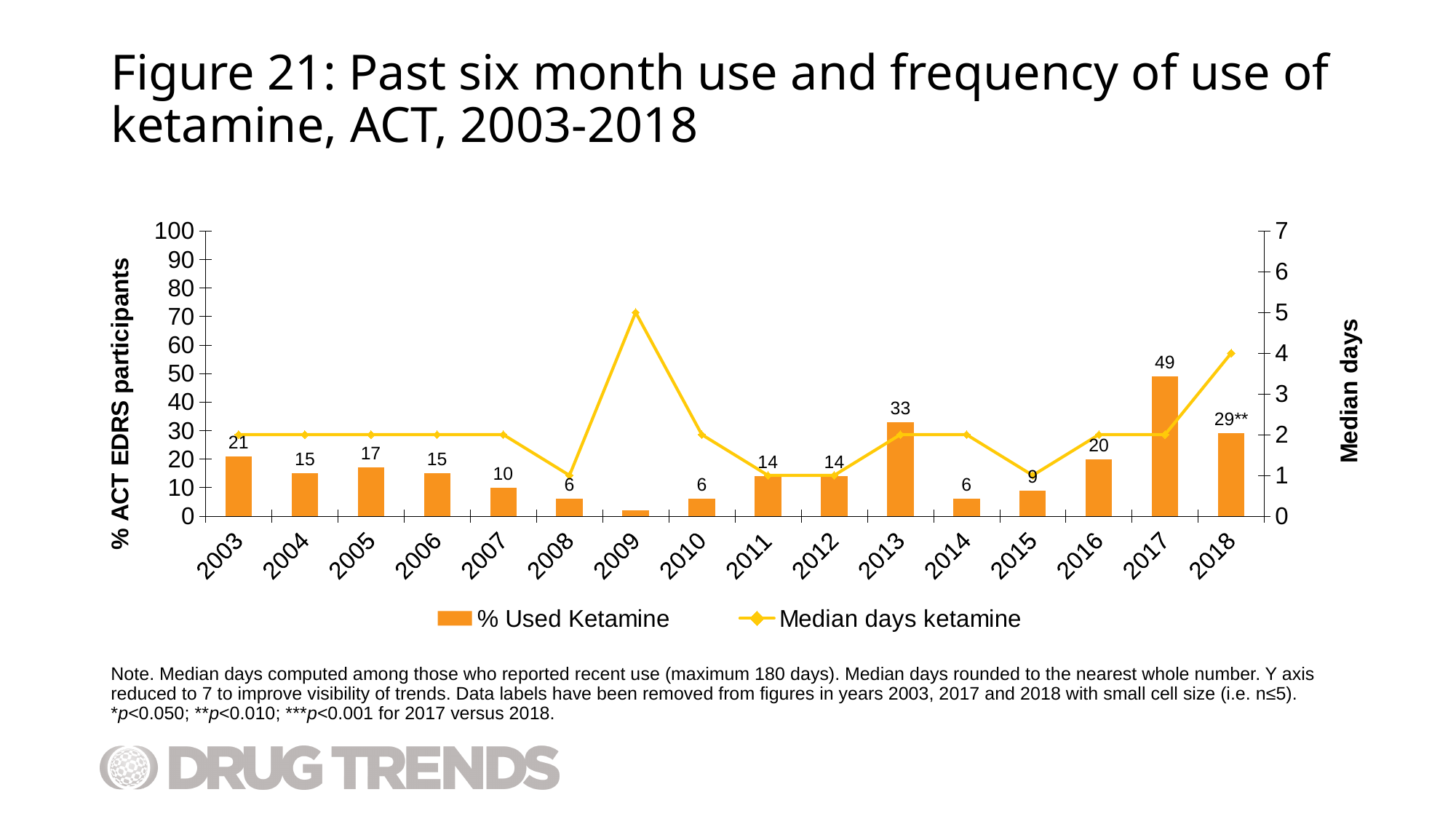
What is the difference between the % Used Ketamine values for 2017 and 2018? 20 What is the label of the right-hand y axis? Median days What is the median days ketamine value for 2018? 4 In which year does the Median days ketamine line reach its peak? 2009 How many series does the legend list? 2 Which year has the lowest % Used Ketamine bar? 2009 Which year has the highest % Used Ketamine value? 2017 How many years are shown on the x axis? 16 What is the data label on the % Used Ketamine bar for 2018? 29** What is the % Used Ketamine value for 2013? 33 What percentage of ACT EDRS participants used ketamine in 2017? 49 Which year has the higher % Used Ketamine value, 2005 or 2016? 2016